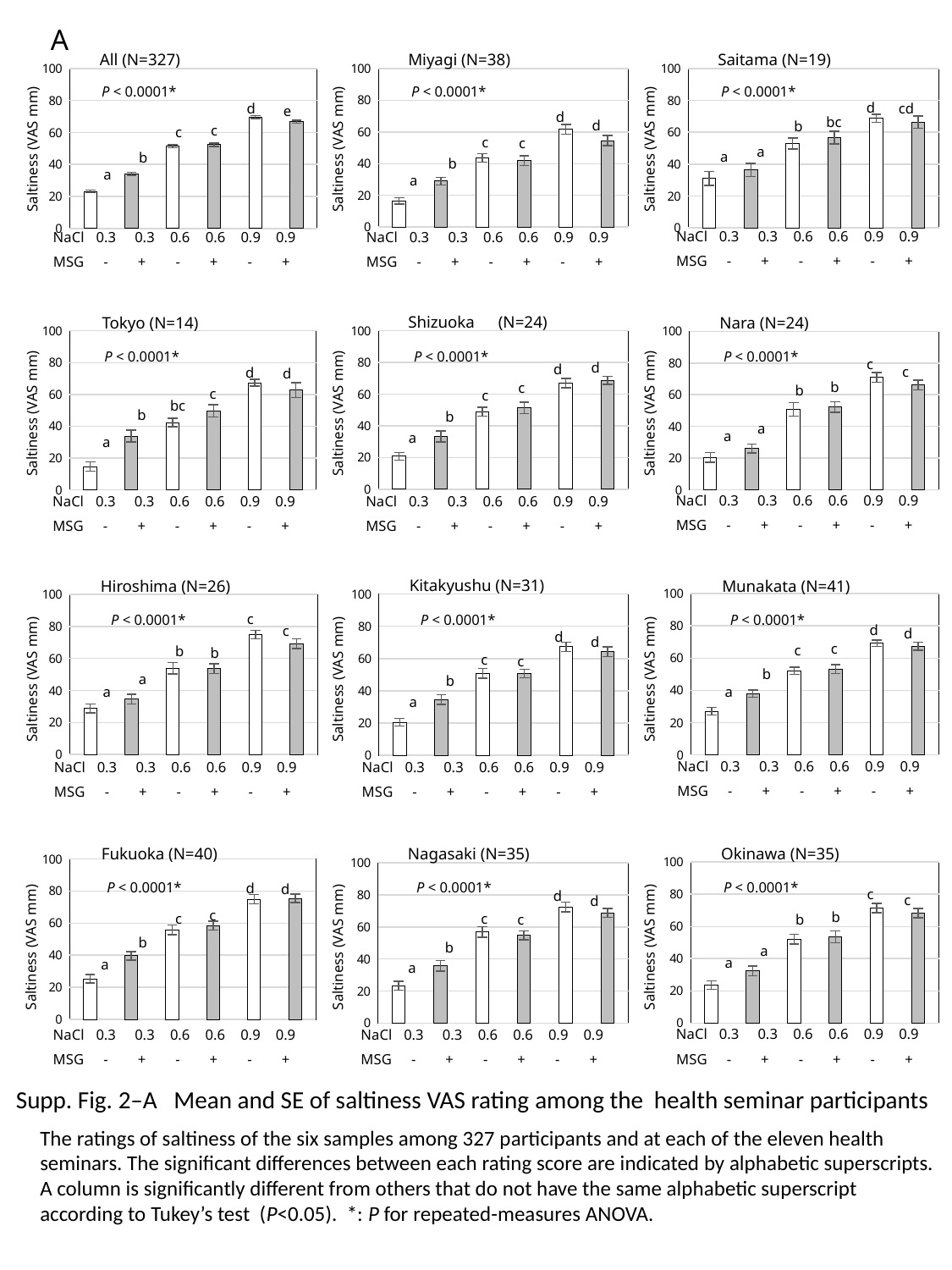
In the 'Hiroshima (N=26)' chart, is the value for NaCl 0.9 without MSG greater or less than 60? greater In the 'Tokyo (N=14)' chart, which bar is the lowest? NaCl 0.3 without MSG What kind of chart is used in the 'All (N=327)' panel? bar chart In the 'All (N=327)' chart, is the value for NaCl 0.9 without MSG greater or less than 60? greater In the 'Miyagi (N=38)' chart, is the value for NaCl 0.3 without MSG greater or less than 20? less In the 'Nara (N=24)' chart, do the saltiness ratings generally rise or fall as NaCl concentration increases from 0.3 to 0.9? rise In the 'All (N=327)' chart, which bar is the lowest? NaCl 0.3 without MSG In the 'All (N=327)' chart, which is larger: the bar for NaCl 0.6 with MSG or the bar for NaCl 0.3 with MSG? NaCl 0.6 with MSG How many separate charts are shown on the slide? 12 How many bars are plotted in the 'Miyagi (N=38)' chart? 6 What P value is printed inside the 'Fukuoka (N=40)' chart? P < 0.0001*